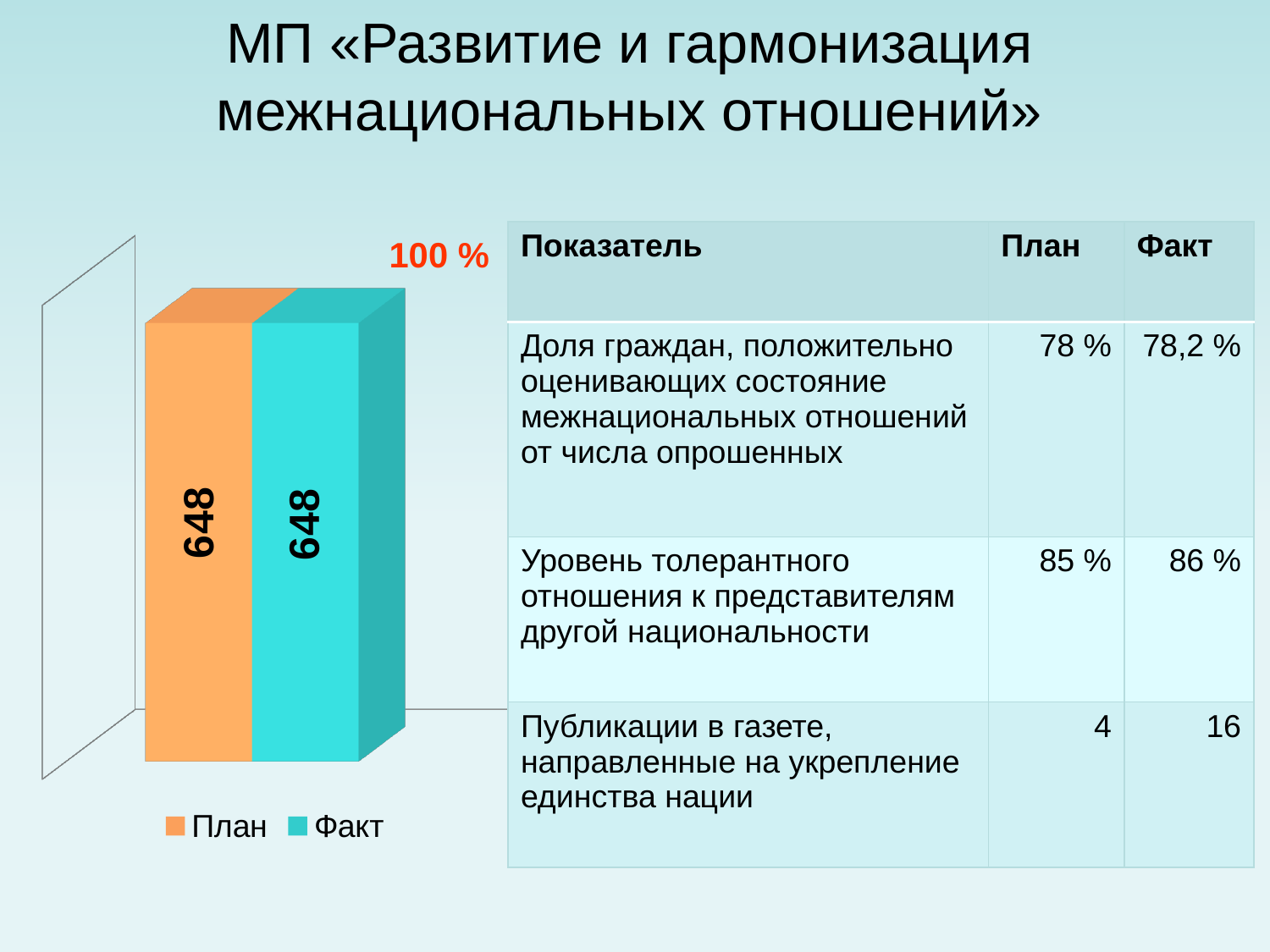
What percentage label is shown in red above the chart? 100 % What is the value of the План bar in the chart? 648 Is the План bar larger than, smaller than, or equal to the Факт bar? Equal Which colour represents Факт in the chart legend? Turquoise (cyan) What is the value of the Факт bar in the chart? 648 How many bars are plotted in the chart? 2 How many series does the chart legend list? 2 What kind of chart is shown on the slide? Bar chart Is the value of the Факт bar greater or less than 600? greater What is the difference between the План and Факт values in the chart? 0